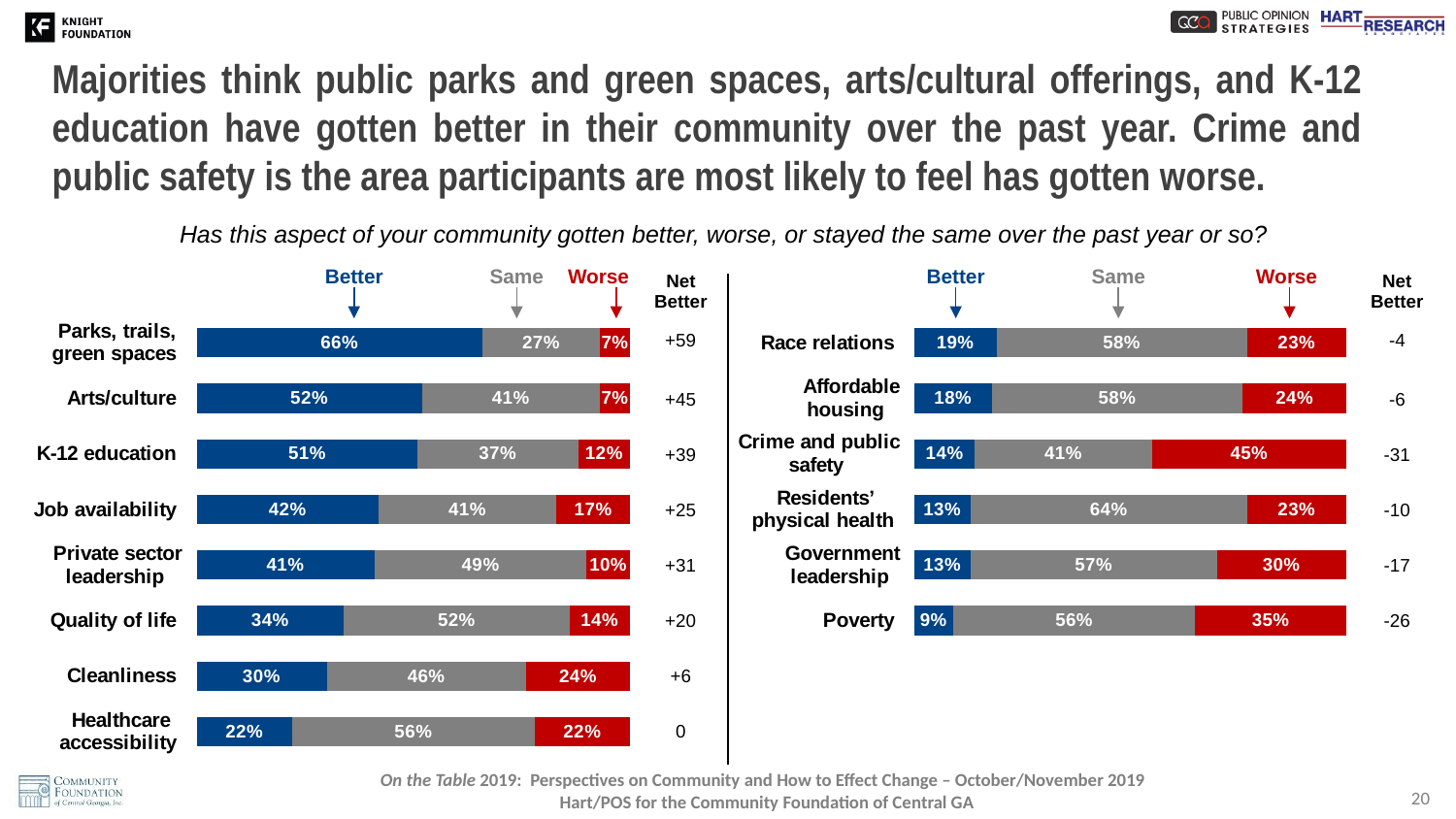
In the right chart, what is the Net Better value for Poverty? -26 What type of chart is used on this slide? Stacked horizontal bar chart How many series (response options) are shown in each chart? 3 In the left chart, what percentage say parks, trails, green spaces have gotten better? 66% How many categories are shown in the left chart? 8 How many categories are shown in the right chart? 6 In the right chart, what percentage say crime and public safety has gotten worse? 45% In the left chart, which is larger: the 'Same' percentage for Quality of life or for Job availability? Quality of life In the left chart, what is the difference between the 'Better' percentages for Arts/culture and Cleanliness? 22 percentage points In the right chart, which category has the lowest 'Better' percentage? Poverty In the right chart, which category has the highest 'Worse' percentage? Crime and public safety In the left chart, what is the Net Better value for K-12 education? +39